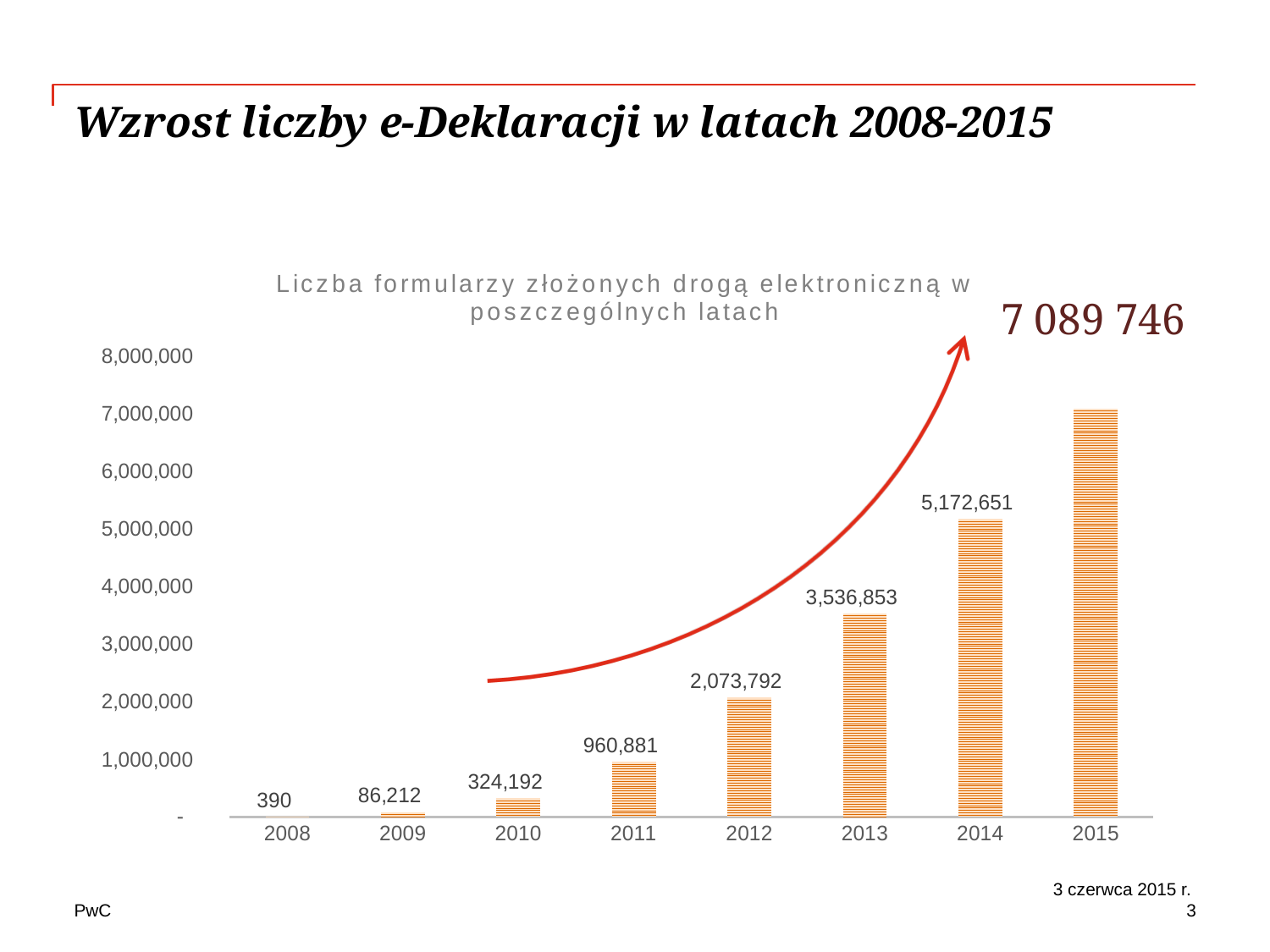
Which year has the lowest value? 2008 What is the value for 2009? 86,212 Which year has the highest value? 2015 What is the difference between the values for 2011 and 2010? 636,689 What kind of chart is shown on the slide? bar chart What is the value for 2008? 390 What is the value for 2013? 3,536,853 Is the value for 2015 greater or less than 6,000,000? greater What is the value for 2011? 960,881 What is the difference between the values for 2014 and 2013? 1,635,798 Which is larger, the value for 2012 or the value for 2011? 2012 How many years are shown on the x axis? 8